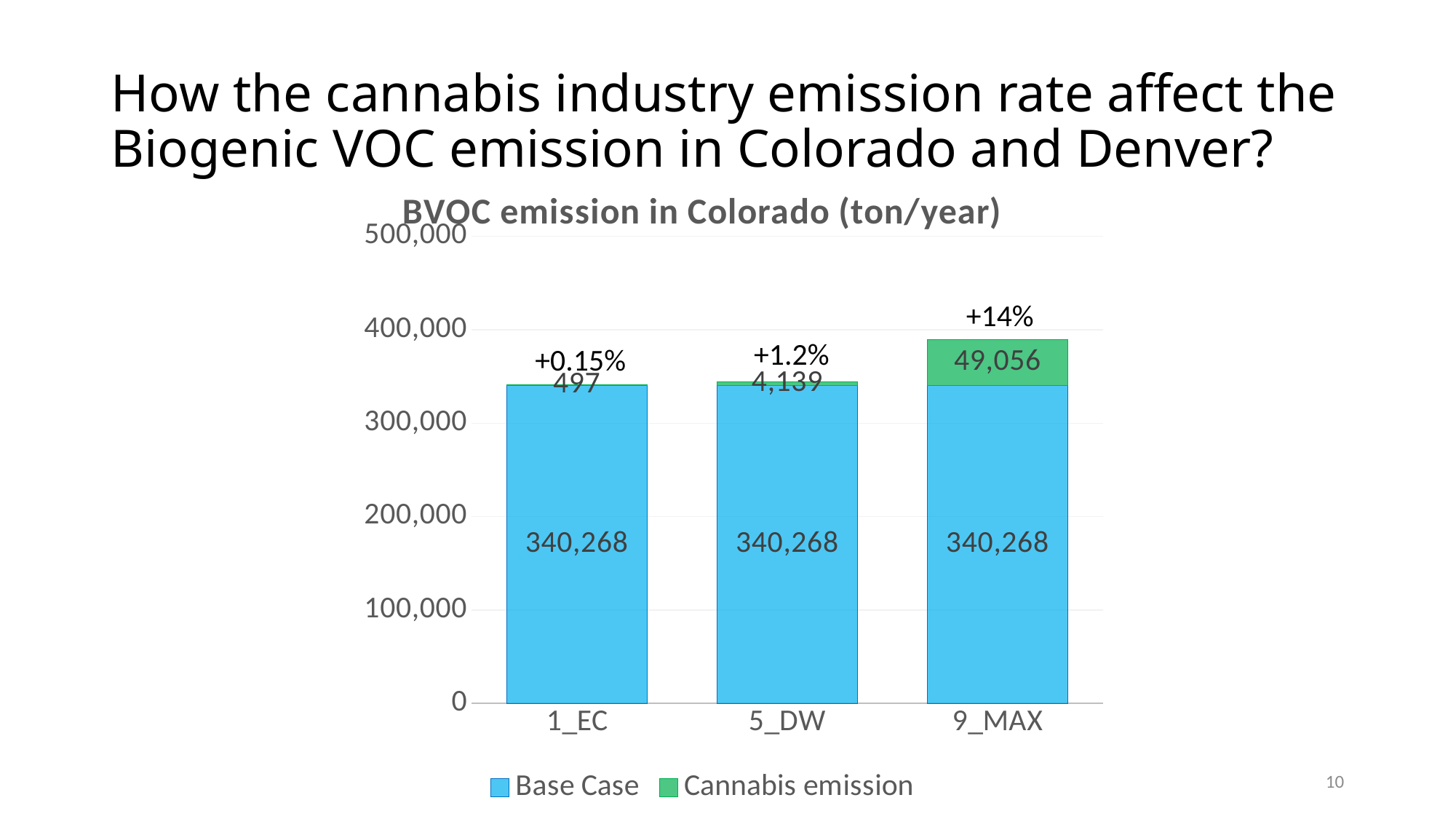
What kind of chart is shown? stacked bar chart What is the Base Case value for 1_EC? 340,268 How many categories are shown on the x axis? 3 Is the Cannabis emission value for 5_DW larger or smaller than that for 1_EC? larger How many series does the legend list? 2 Which category has the highest Cannabis emission value? 9_MAX Which category has the lowest Cannabis emission value? 1_EC What is the difference between the Cannabis emission values for 9_MAX and 5_DW? 44,917 What is the Cannabis emission value for 5_DW? 4,139 What is the Cannabis emission value for 1_EC? 497 What is the total of the stacked bar for 9_MAX? 389,324 What is the Cannabis emission value for 9_MAX? 49,056